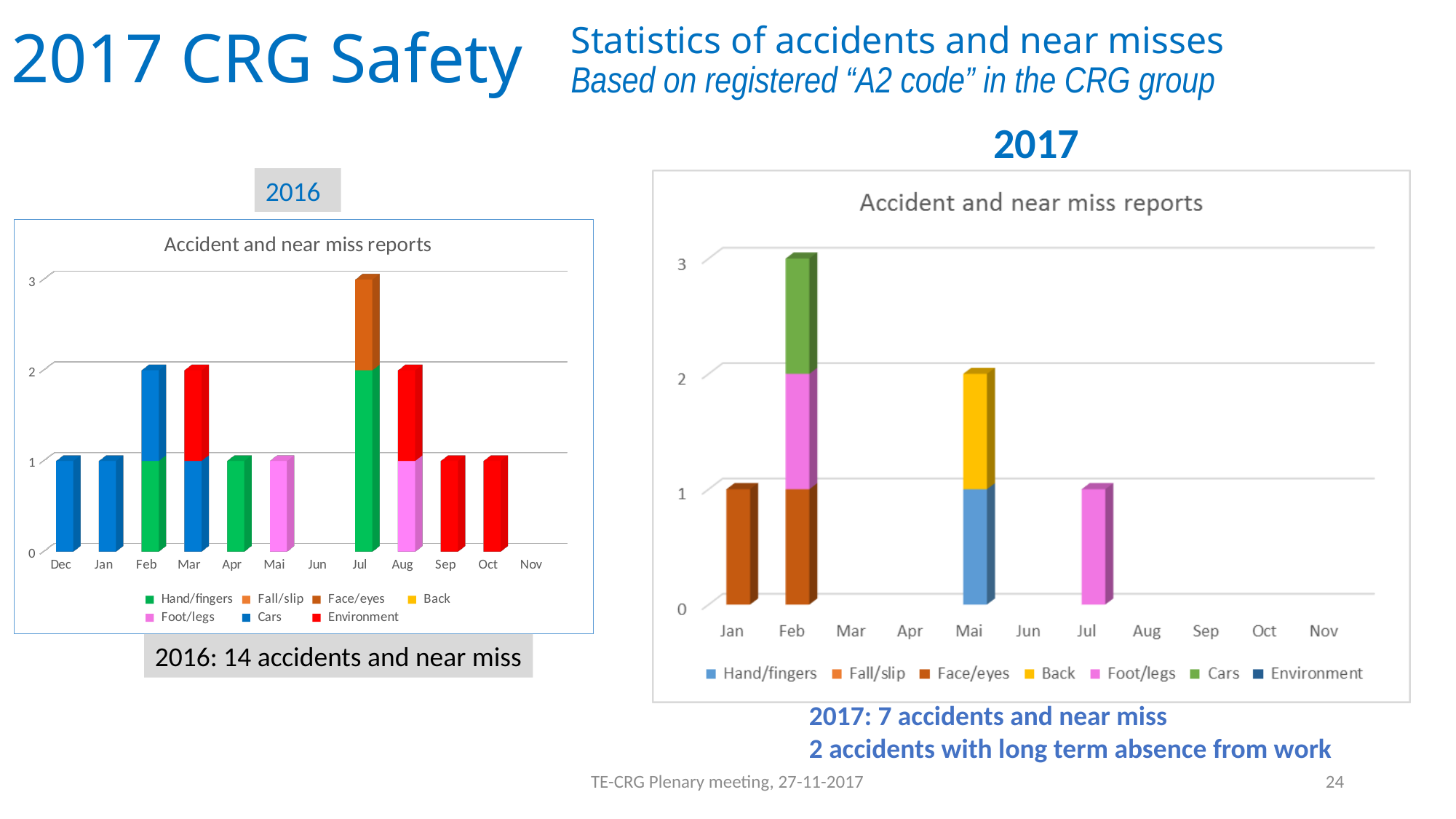
What kind of chart is the 2017 'Accident and near miss reports' chart? Stacked bar chart In the 2016 chart, how many series does the legend list? 7 In the 2016 chart, what is the total height of the stacked bar for Jul? 3 In the 2016 chart, which month has the highest total number of reports? Jul In the 2017 chart, which month has the highest total number of reports? Feb In the 2017 chart, what is the total height of the stacked bar for Mai? 2 In the 2017 chart, how many series does the legend list? 7 What is the title of the 2017 chart? Accident and near miss reports In the 2017 chart, what is the total height of the stacked bar for Feb? 3 In the 2017 chart, how many months are shown on the x axis? 11 In the 2016 chart, what is the difference between the total for Jul and the total for Aug? 1 In the 2016 chart, which is larger, the total for Mar or the total for Apr? Mar